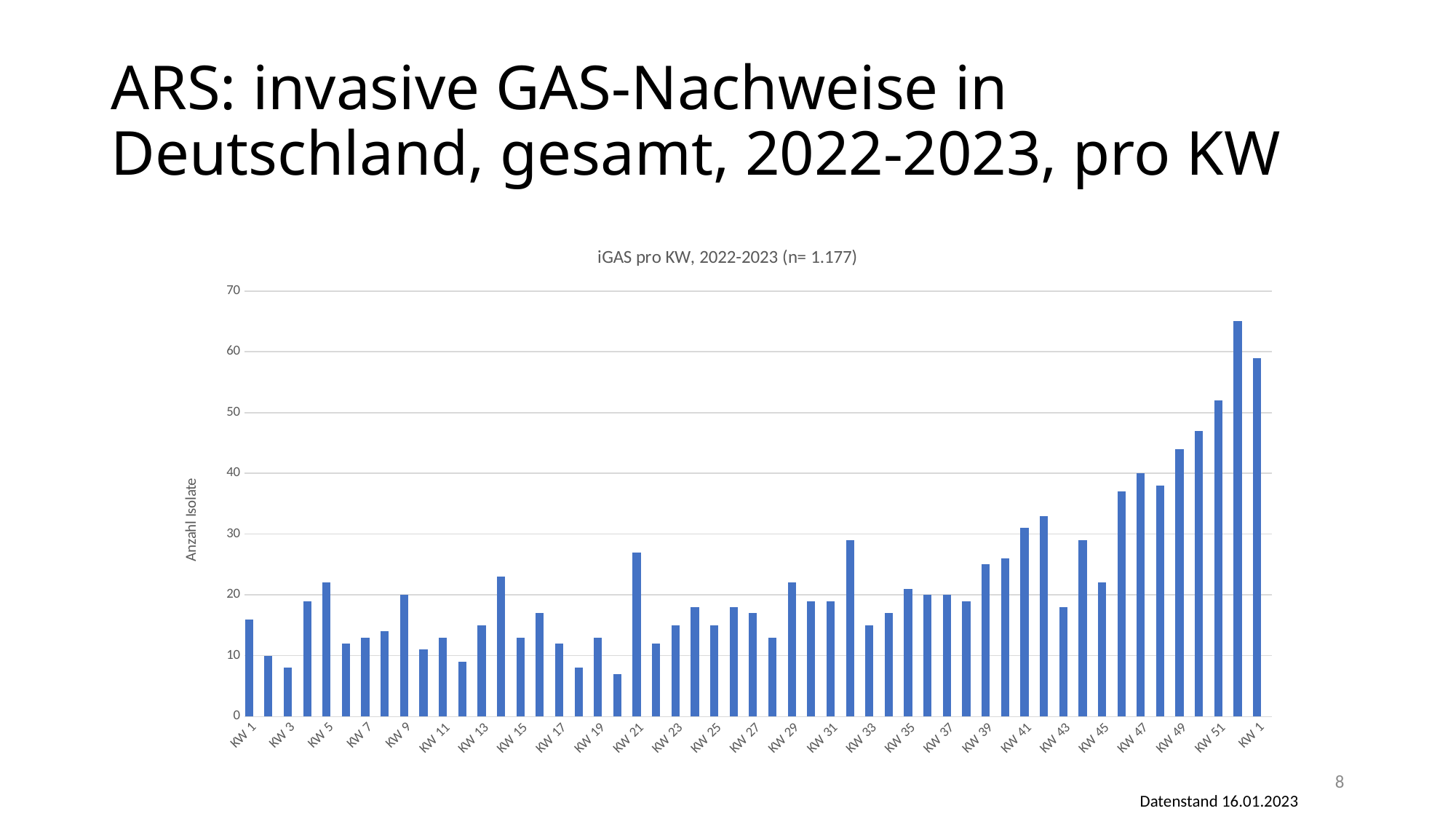
What is the title of the chart? iGAS pro KW, 2022-2023 (n= 1.177) What kind of chart is shown on the slide? bar chart Is the value for the first KW 1 bar greater or less than 20? less Which has the higher value, KW 21 or KW 23? KW 21 Is the value for KW 49 greater or less than 40? greater Is the value for KW 45 greater or less than 30? less Which has the higher value, KW 3 or KW 5? KW 5 What is the label of the vertical axis? Anzahl Isolate Do the values generally rise or fall over the last part of the x axis, from KW 43 to the end? rise